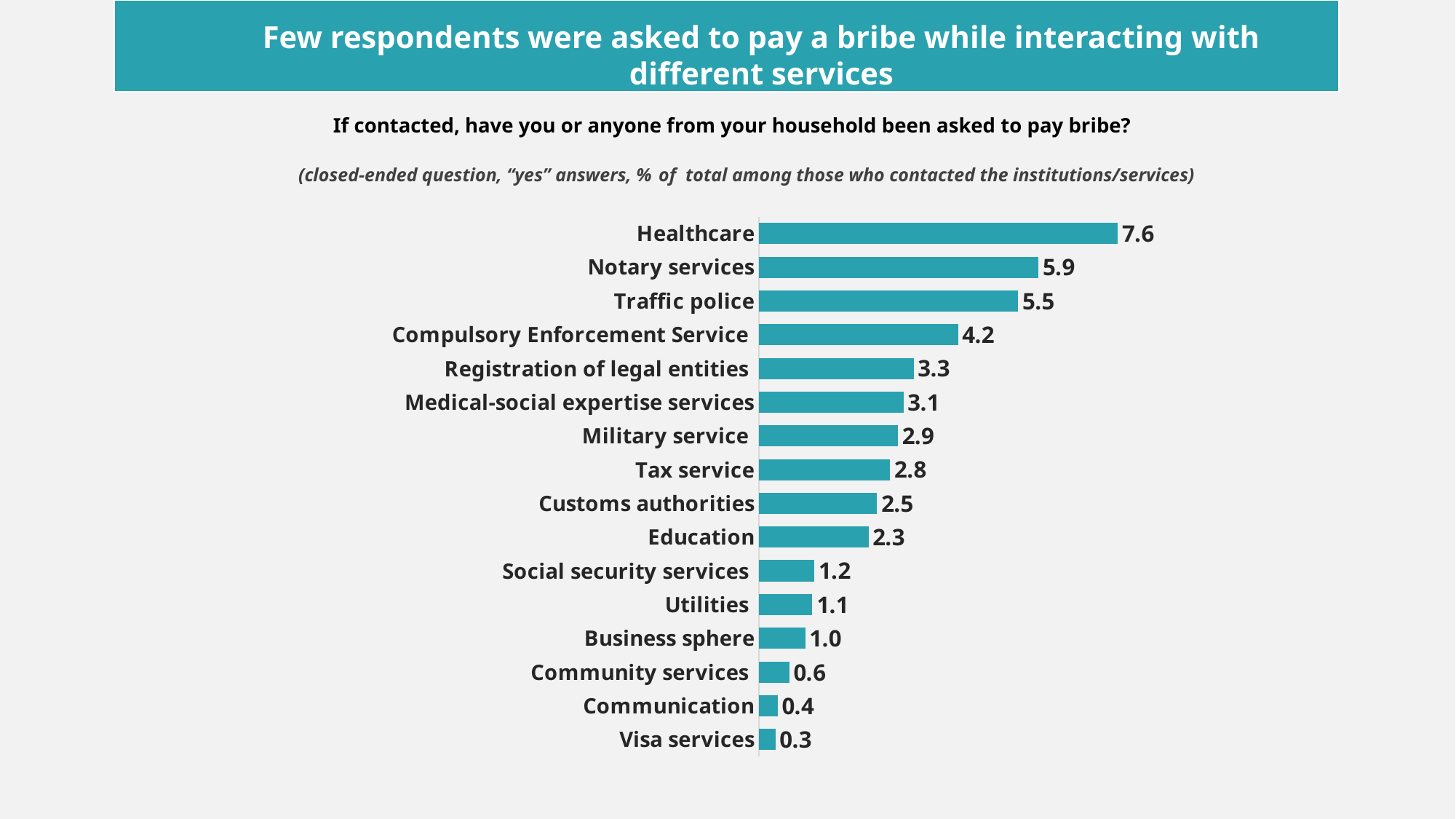
What is the title of the slide? Few respondents were asked to pay a bribe while interacting with different services Which category has the highest value? Healthcare What is the value for Customs authorities? 2.5 What is the value for Community services? 0.6 How many categories are shown in the chart? 16 What kind of chart is shown on the slide? Bar chart What is the value for Traffic police? 5.5 Which category has the lowest value? Visa services Which is larger, the value for Military service or the value for Social security services? Military service What is the difference between the values for Healthcare and Notary services? 1.7 What is the difference between the values for Compulsory Enforcement Service and Education? 1.9 What is the value for Healthcare? 7.6